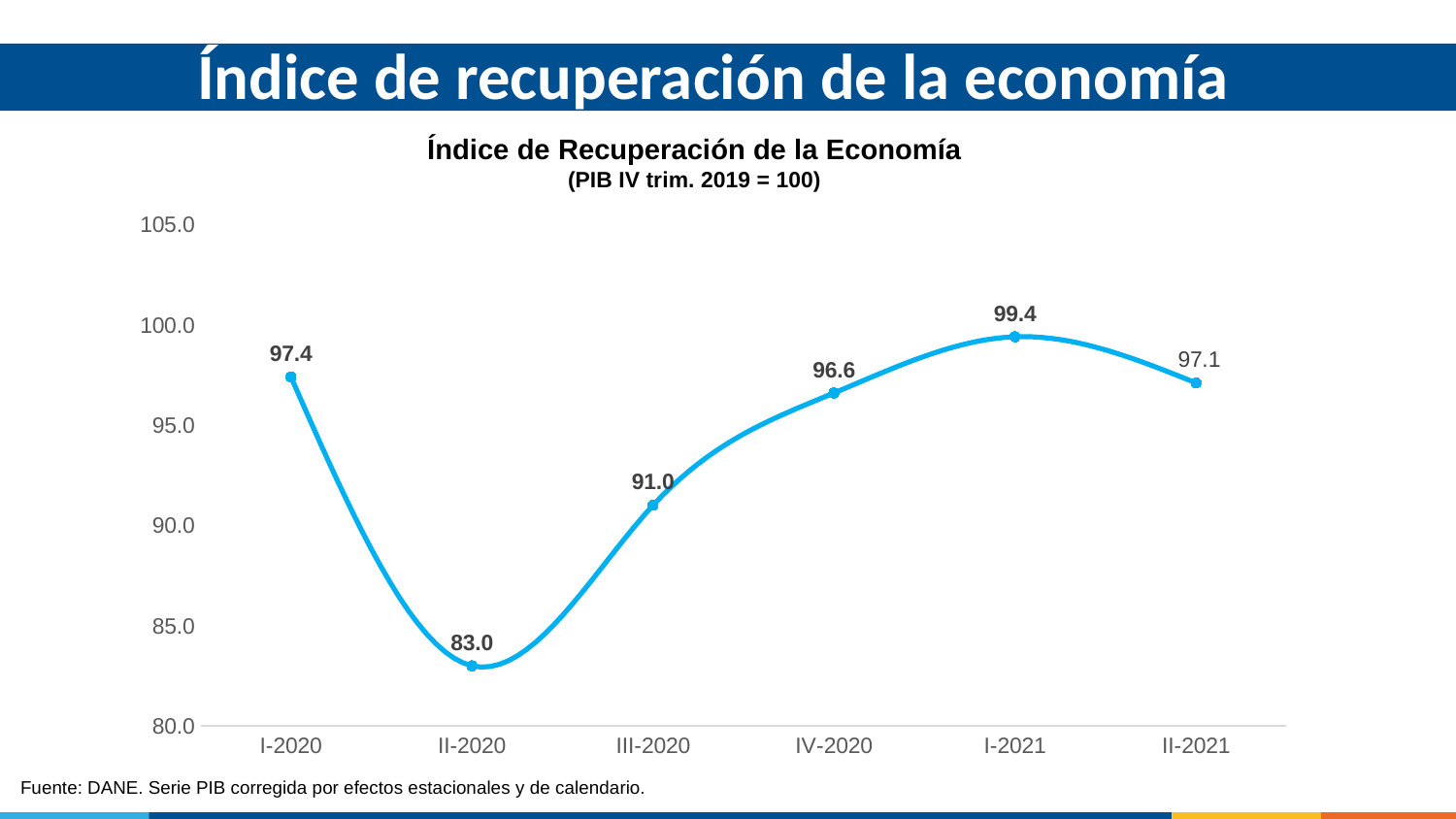
Is the value for III-2020 greater or less than 95.0? less What is the value of the index for II-2020? 83.0 What is the difference between the index values for I-2021 and II-2020? 16.4 Which is larger, the index value for I-2020 or for IV-2020? I-2020 Which quarter has the lowest index value? II-2020 What kind of chart is shown on the slide? line chart Which quarter has the highest index value? I-2021 Does the index rise or fall from II-2020 to I-2021? rise What is the value of the index for II-2021? 97.1 What base period is the index set to 100, according to the chart subtitle? PIB IV trim. 2019 What is the value of the index for I-2021? 99.4 How many quarters are plotted on the chart? 6